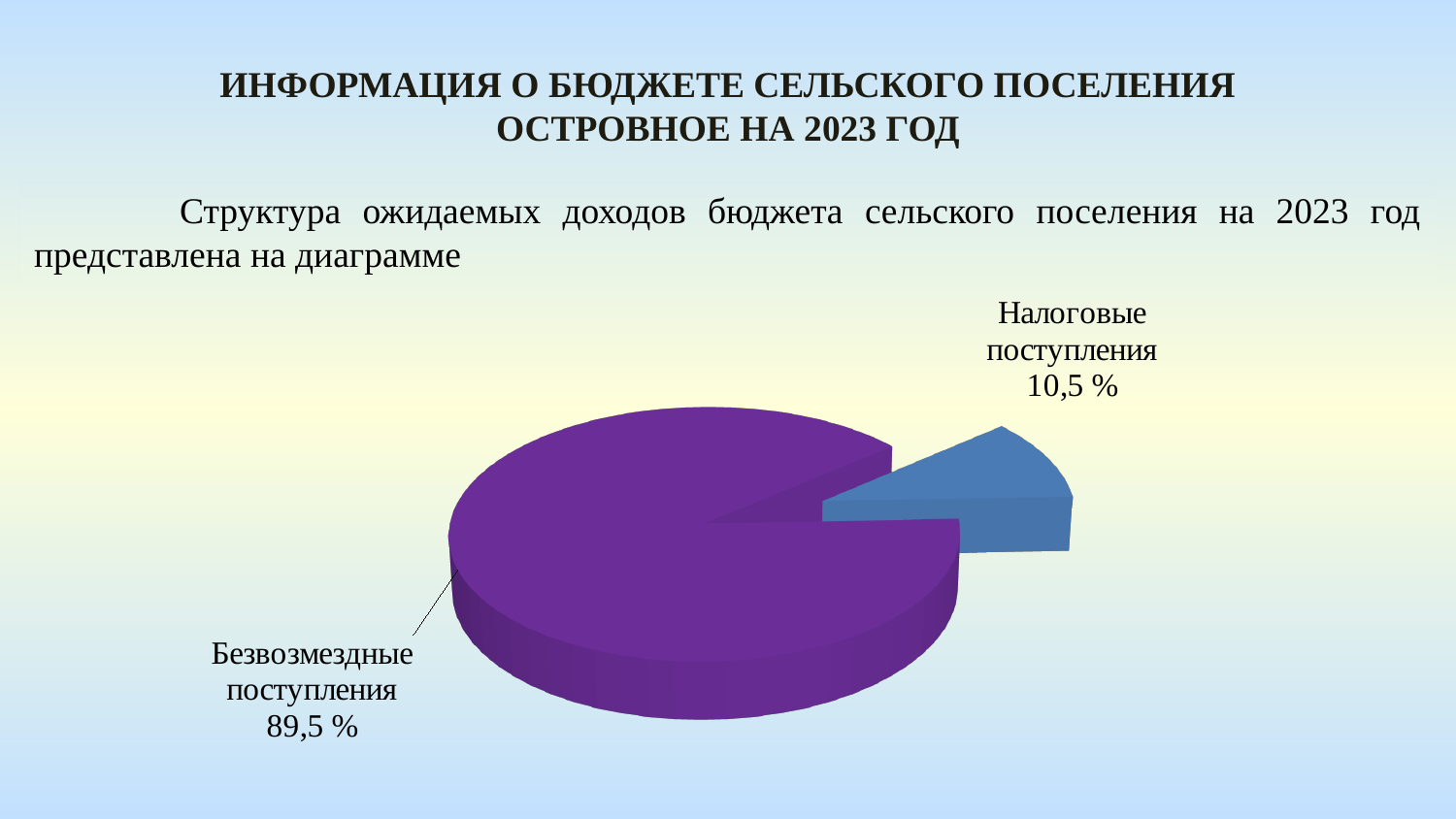
What share of the pie is labelled "Безвозмездные поступления"? 89,5 % What is the difference in percentage points between "Безвозмездные поступления" and "Налоговые поступления"? 79 percentage points Which slice of the pie is the smallest? Налоговые поступления What kind of chart is shown on the slide? Pie chart What colour is the slice for "Налоговые поступления"? Blue How many slices does the pie chart have? 2 Which slice of the pie is the largest? Безвозмездные поступления Is the share for "Налоговые поступления" greater or less than 50%? less Which is larger: "Налоговые поступления" or "Безвозмездные поступления"? Безвозмездные поступления What colour is the slice for "Безвозмездные поступления"? Purple What share of the pie is labelled "Налоговые поступления"? 10,5 %